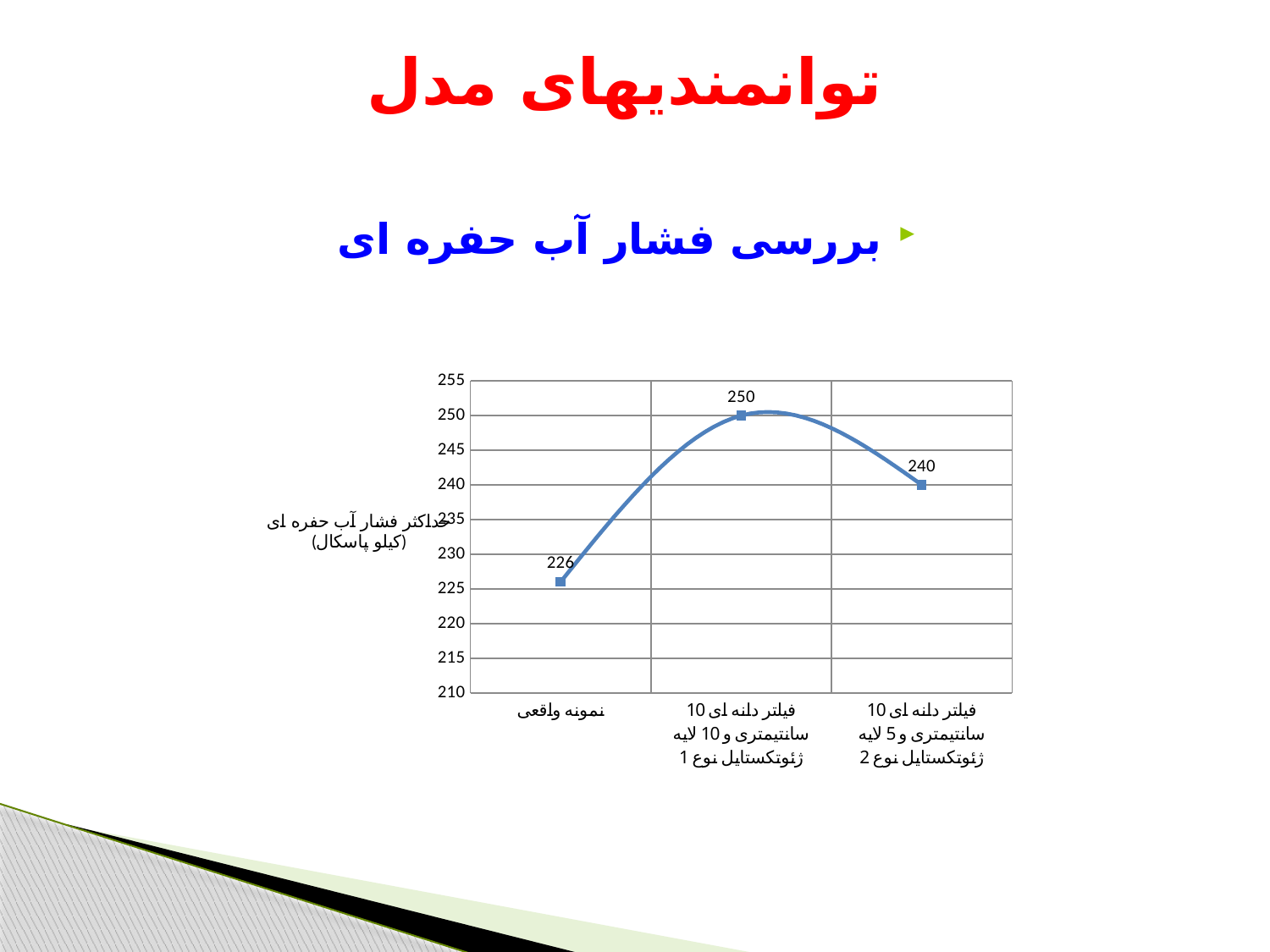
What is the value for فیلتر دلنه ای 10 سانتیمتری و 5 لایه ژئوتکستایل نوع 2? 240 How many categories are plotted on the x axis? 3 What is the label of the vertical axis? حداکثر فشار آب حفره ای (کیلو پاسکال) Which is larger: the value for نمونه واقعی or the value for فیلتر دلنه ای 10 سانتیمتری و 5 لایه ژئوتکستایل نوع 2? فیلتر دلنه ای 10 سانتیمتری و 5 لایه ژئوتکستایل نوع 2 What kind of chart is shown on the slide? line chart What is the value for نمونه واقعی? 226 Which category has the highest value? فیلتر دلنه ای 10 سانتیمتری و 10 لایه ژئوتکستایل نوع 1 What is the value for فیلتر دلنه ای 10 سانتیمتری و 10 لایه ژئوتکستایل نوع 1? 250 Which category has the lowest value? نمونه واقعی What is the difference between the value for فیلتر دلنه ای 10 سانتیمتری و 10 لایه ژئوتکستایل نوع 1 and the value for نمونه واقعی? 24 What is the difference between the value for فیلتر دلنه ای 10 سانتیمتری و 10 لایه ژئوتکستایل نوع 1 and the value for فیلتر دلنه ای 10 سانتیمتری و 5 لایه ژئوتکستایل نوع 2? 10 Is the value for نمونه واقعی greater or less than 230? less